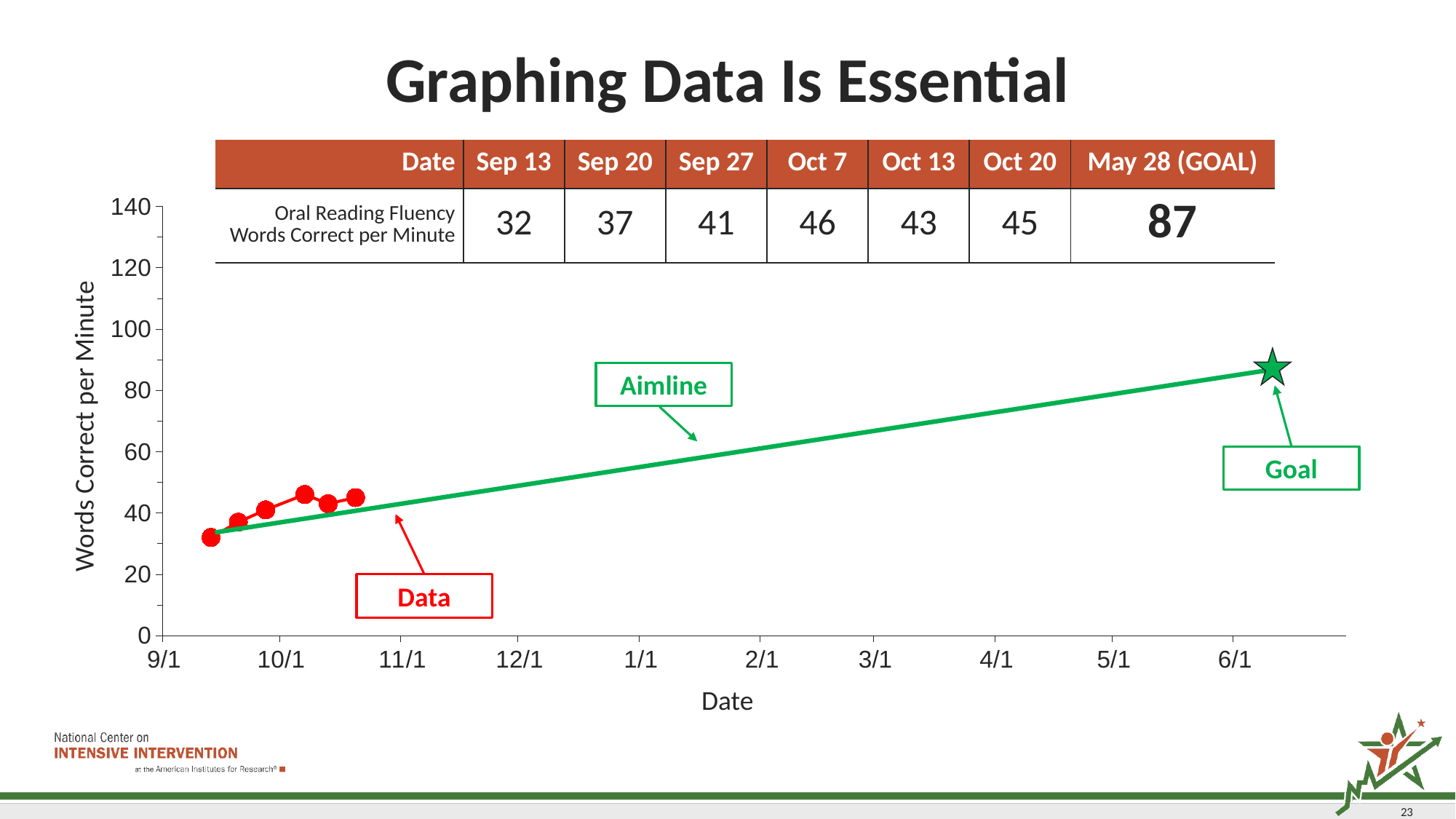
Which date has the lowest Oral Reading Fluency score? Sep 13 What is the Oral Reading Fluency value for Sep 13? 32 How many red data points are plotted on the chart? 6 Which date has the highest Oral Reading Fluency score among the six data points? Oct 7 What is the difference between the Oct 7 value and the Sep 13 value? 14 What is the label on the y axis of the chart? Words Correct per Minute What is the goal value for May 28? 87 What does the green line on the chart represent? Aimline Which is larger, the value for Oct 13 or the value for Oct 20? Oct 20 What is the Oral Reading Fluency value for Oct 7? 46 What type of chart is shown on the slide? line chart Is the goal value on the chart greater or less than 80? greater